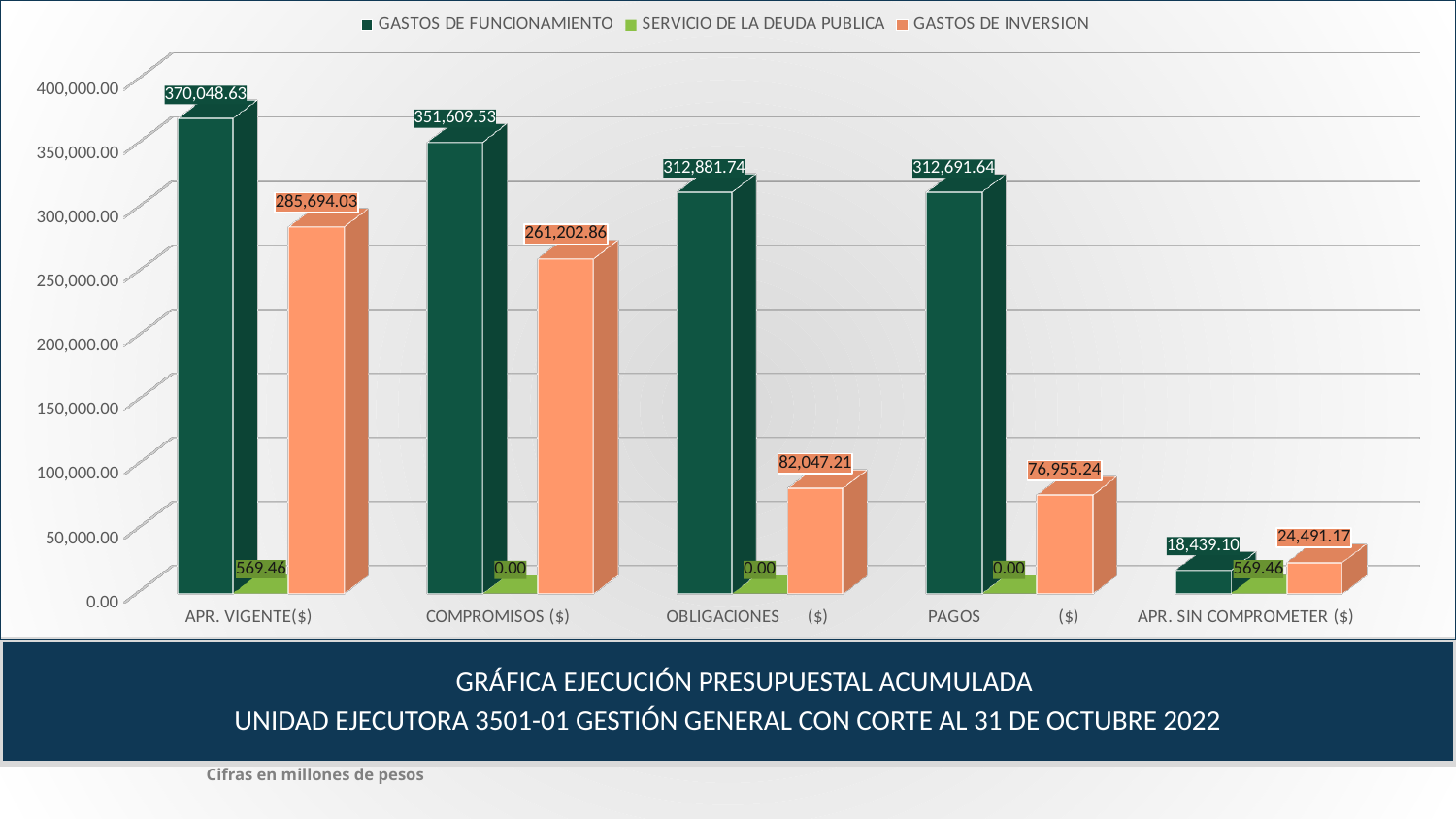
What is the value of GASTOS DE INVERSION for COMPROMISOS ($)? 261,202.86 How many series does the legend list? 3 Which category has the lowest value for GASTOS DE INVERSION? APR. SIN COMPROMETER ($) Which category has the highest value for GASTOS DE FUNCIONAMIENTO? APR. VIGENTE($) What kind of chart is shown on the slide? Bar chart How many categories are shown on the x axis? 5 Which is larger for APR. SIN COMPROMETER ($): GASTOS DE FUNCIONAMIENTO or GASTOS DE INVERSION? GASTOS DE INVERSION What is the value of GASTOS DE INVERSION for PAGOS ($)? 76,955.24 What is the total of the three series for COMPROMISOS ($)? 612,812.39 What is the difference between GASTOS DE INVERSION for OBLIGACIONES ($) and for PAGOS ($)? 5,091.97 What is the value of GASTOS DE FUNCIONAMIENTO for APR. VIGENTE($)? 370,048.63 What is the value of SERVICIO DE LA DEUDA PUBLICA for APR. SIN COMPROMETER ($)? 569.46